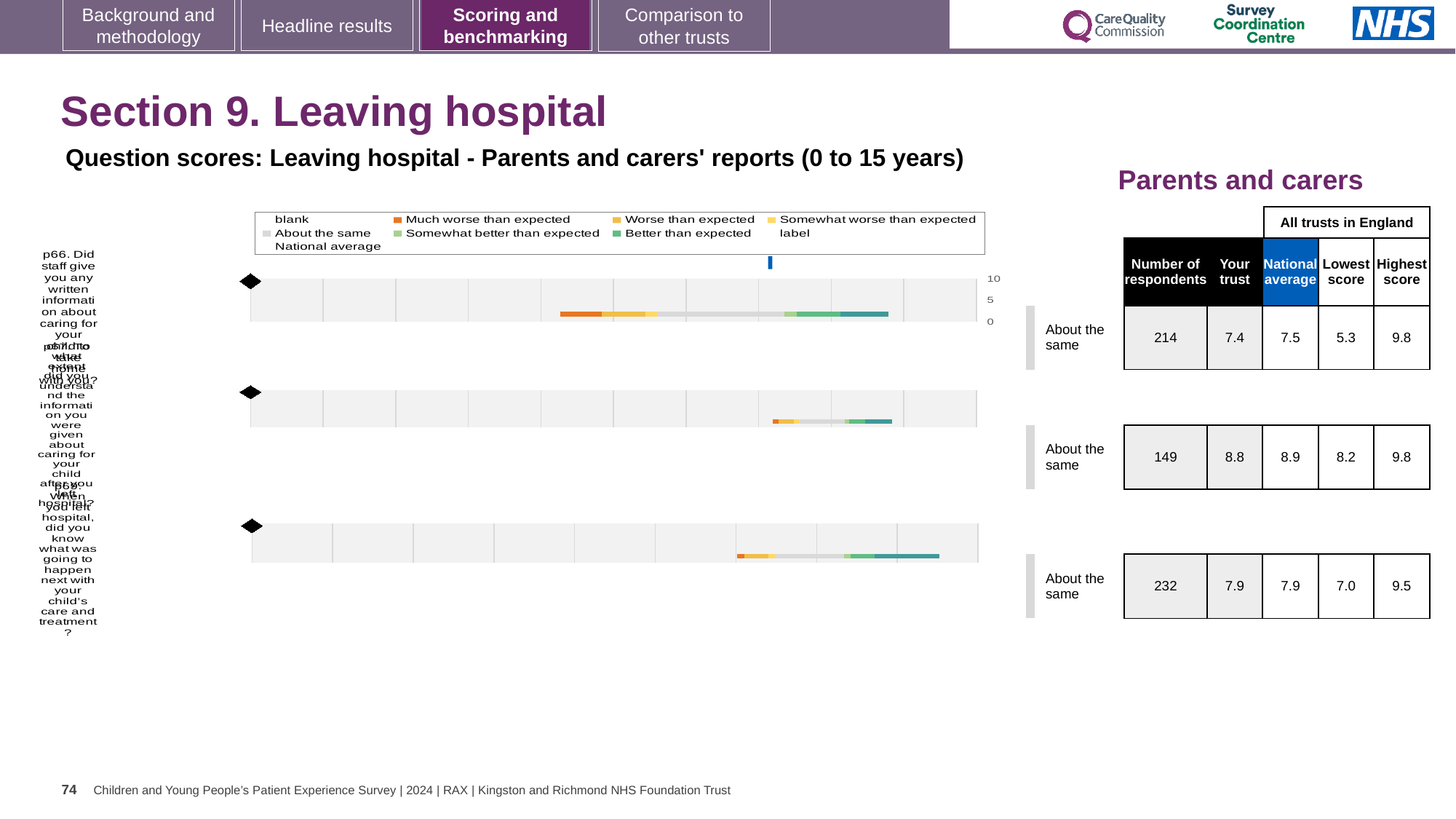
Which of the three charts has the highest 'Your trust' score? the middle chart What kind of chart is used to show the question scores on the slide? bar chart What is the 'Your trust' score for the top chart (p66, written information about caring for your child at home)? 7.4 What is the 'Your trust' score for the middle chart? 8.8 What is the 'Your trust' score for the bottom chart (p68, knowing what was going to happen next)? 7.9 What is the lowest score across all trusts in England for the bottom chart (p68)? 7.0 How many benchmark bar charts are shown on the slide? 3 What is the difference between the highest score (9.8) and the lowest score (5.3) for the top chart (p66)? 4.5 What is the national average for the top chart (p66)? 7.5 Which legend entry is shown in orange? Much worse than expected How many entries does the legend above the charts list? 9 Is the 'Your trust' score for the middle chart larger or smaller than the national average for that chart? smaller